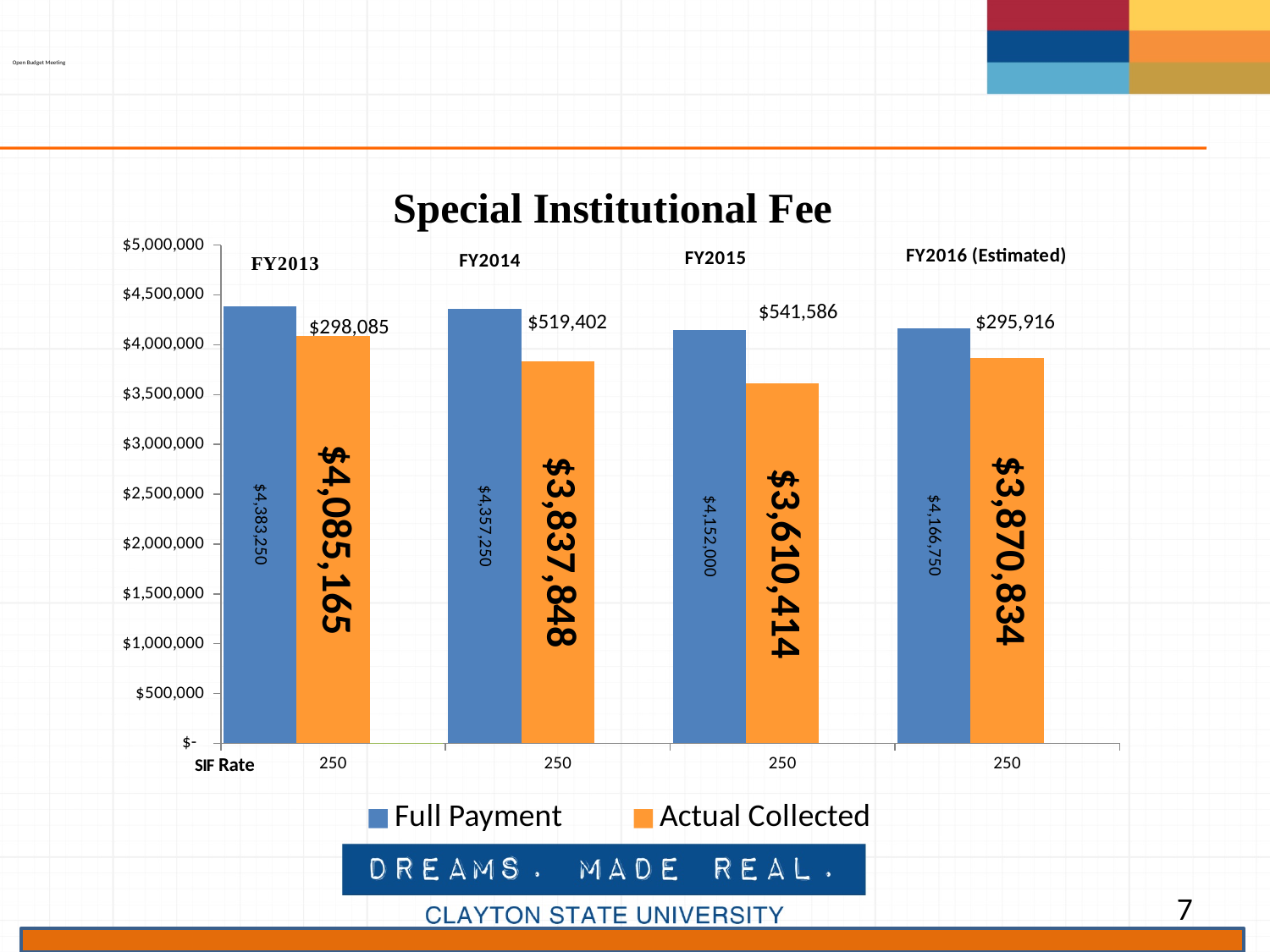
What is the Actual Collected value for FY2016 (Estimated)? $3,870,834 How many fiscal years are shown on the x axis? 4 What type of chart is shown on the slide? Bar chart What is the Actual Collected value for FY2015? $3,610,414 What is the difference between Full Payment and Actual Collected in FY2014? $519,402 How many series does the legend list? 2 Which is larger in FY2016 (Estimated): Full Payment or Actual Collected? Full Payment What is the title of the chart? Special Institutional Fee What SIF Rate is shown for FY2013? 250 Which fiscal year has the lowest Actual Collected value? FY2015 What is the Full Payment value for FY2013? $4,383,250 Which fiscal year has the highest Full Payment value? FY2013